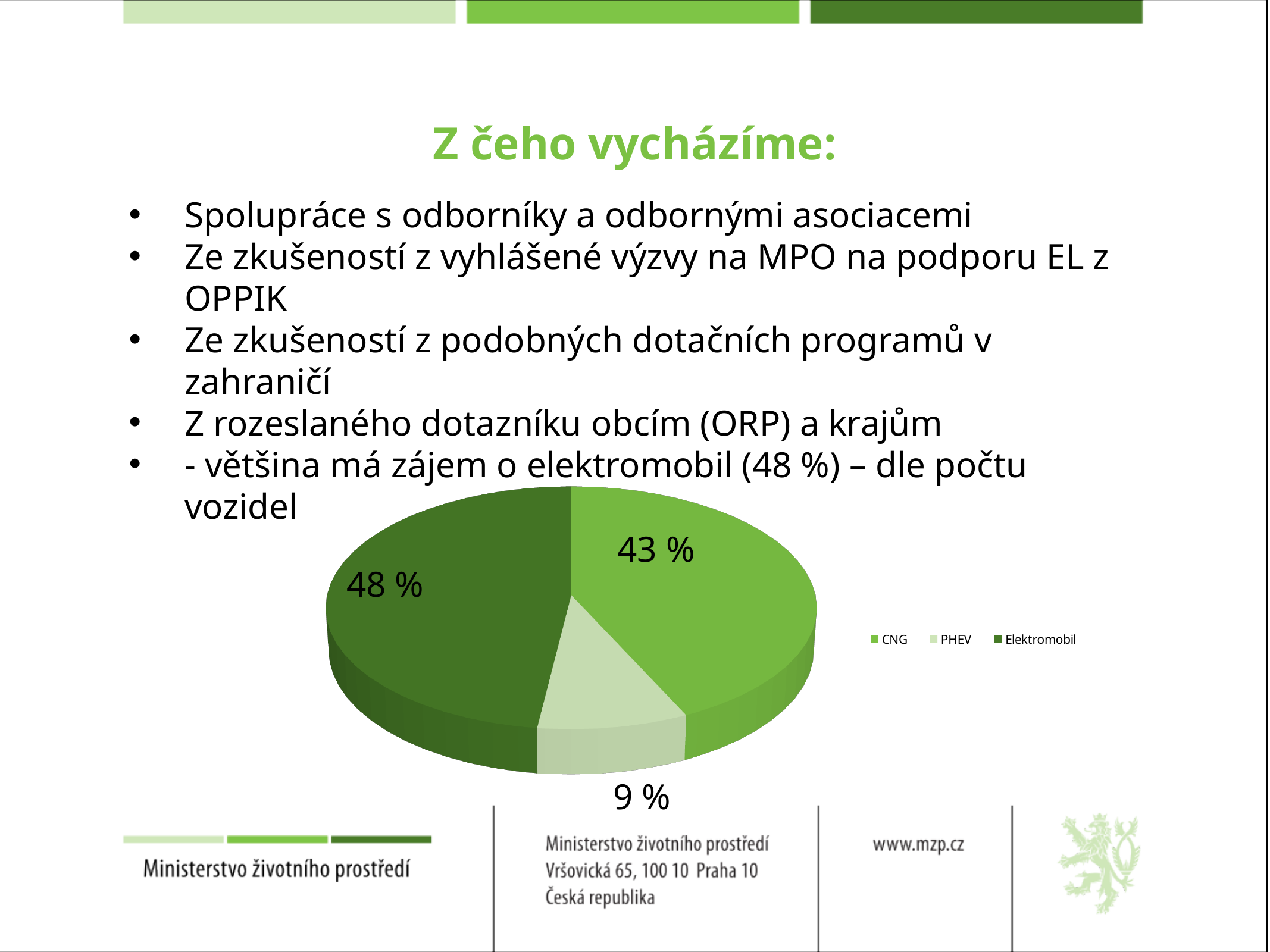
How many slices does the pie chart have? 3 Which legend entry is shown in the lightest green colour? PHEV Which category has the largest slice of the pie? Elektromobil Which slice is larger, CNG or PHEV? CNG What is the difference in percentage points between the Elektromobil and CNG slices? 5 % What is the difference in percentage points between the CNG and PHEV slices? 34 % What share of the pie does CNG have? 43 % What share of the pie does PHEV have? 9 % What kind of chart is shown on the slide? Pie chart How many entries does the legend list? 3 What share of the pie does Elektromobil have? 48 % Which category has the smallest slice of the pie? PHEV